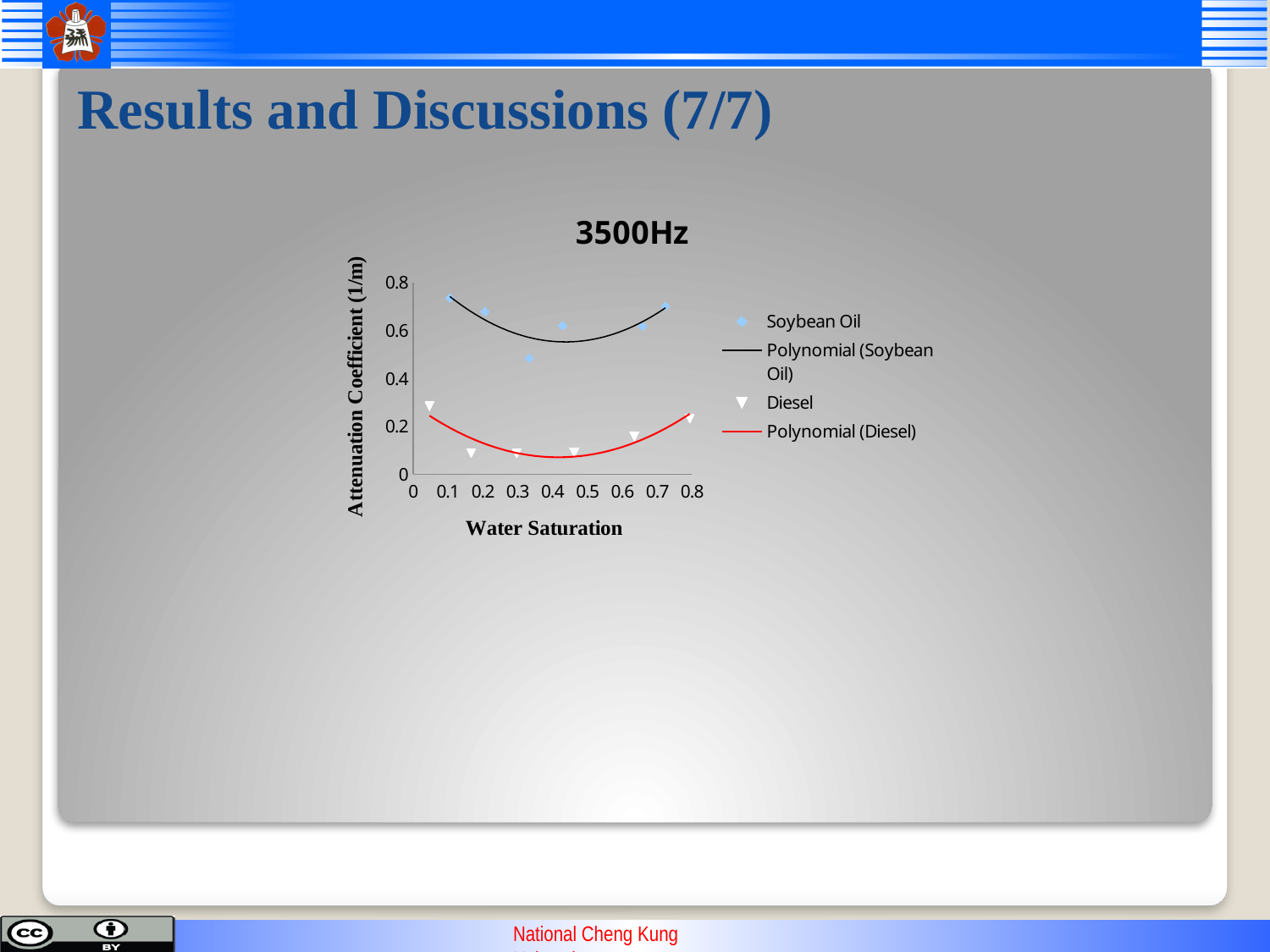
Is the attenuation coefficient for Diesel at a water saturation of 0.2 greater or less than 0.2? less Does the Polynomial (Diesel) trendline rise or fall as water saturation increases from 0 to 0.4? fall Does the Polynomial (Soybean Oil) trendline rise or fall as water saturation increases from 0.4 to 0.8? rise What type of chart is shown on the slide? scatter chart Is the attenuation coefficient for Soybean Oil at a water saturation of 0.1 greater or less than 0.6? greater Which series has the higher attenuation coefficient at a water saturation of 0.4, Soybean Oil or Diesel? Soybean Oil How many entries does the chart legend list? 4 What is the label of the x axis? Water Saturation Are all the Diesel data points below 0.4 on the y axis? yes Which series has the lower attenuation coefficient overall, Soybean Oil or Diesel? Diesel What is the title of the chart? 3500Hz Which series is plotted with the red trendline? Polynomial (Diesel)